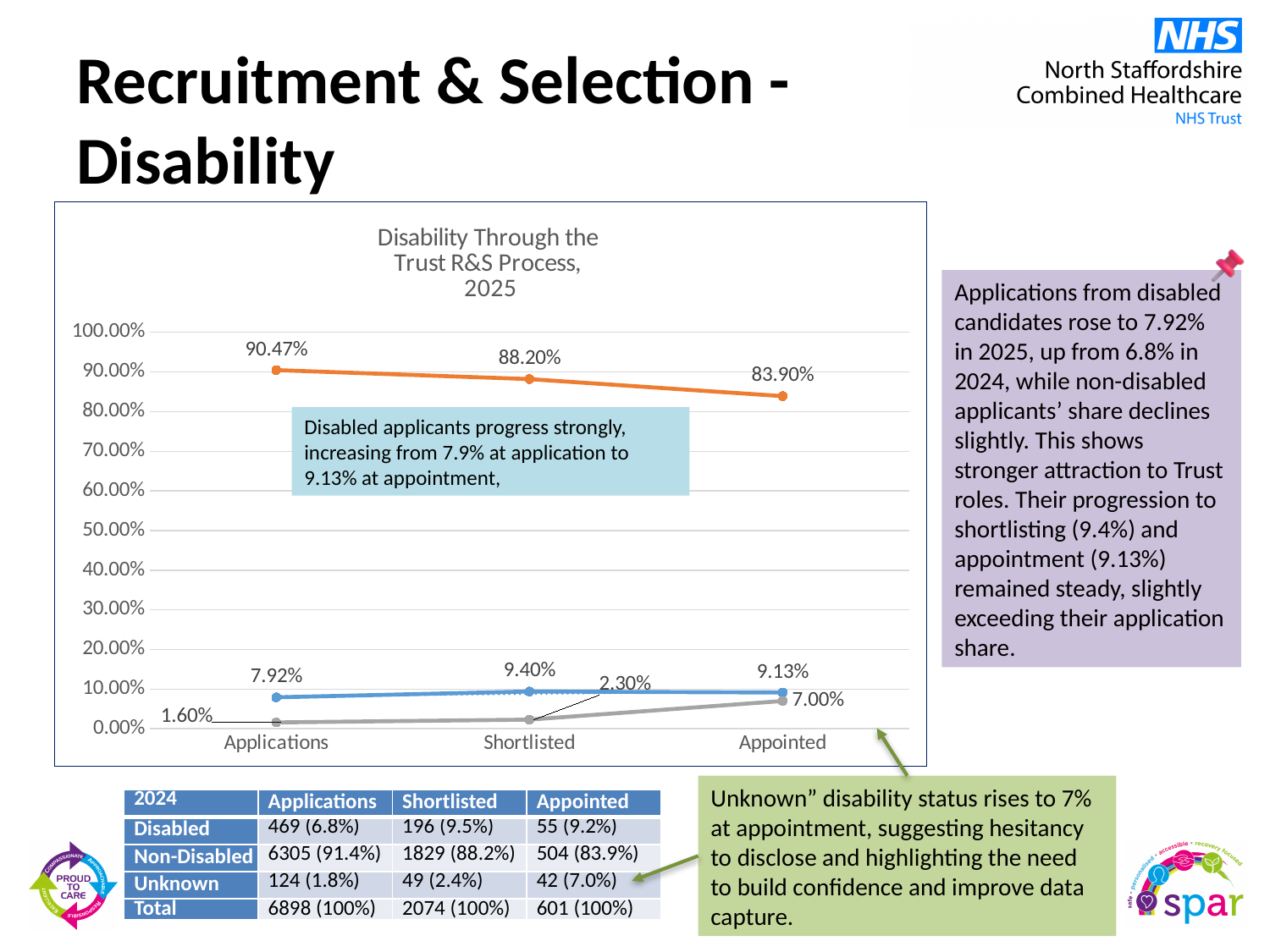
What is the title of the chart? Disability Through the Trust R&S Process, 2025 What is the value of the orange line at Applications? 90.47% What is the difference between the orange line's values at Applications and Appointed? 6.57% Does the orange line rise or fall from Applications to Appointed? Fall What is the value of the orange line at Appointed? 83.90% What kind of chart is shown on the slide? Line chart How many categories are shown on the x axis of the chart? 3 What is the value of the blue line at Shortlisted? 9.40% At which category is the orange line highest? Applications At which category is the grey line lowest? Applications What is the value of the grey line at Appointed? 7.00% What is the value of the grey line at Applications? 1.60%